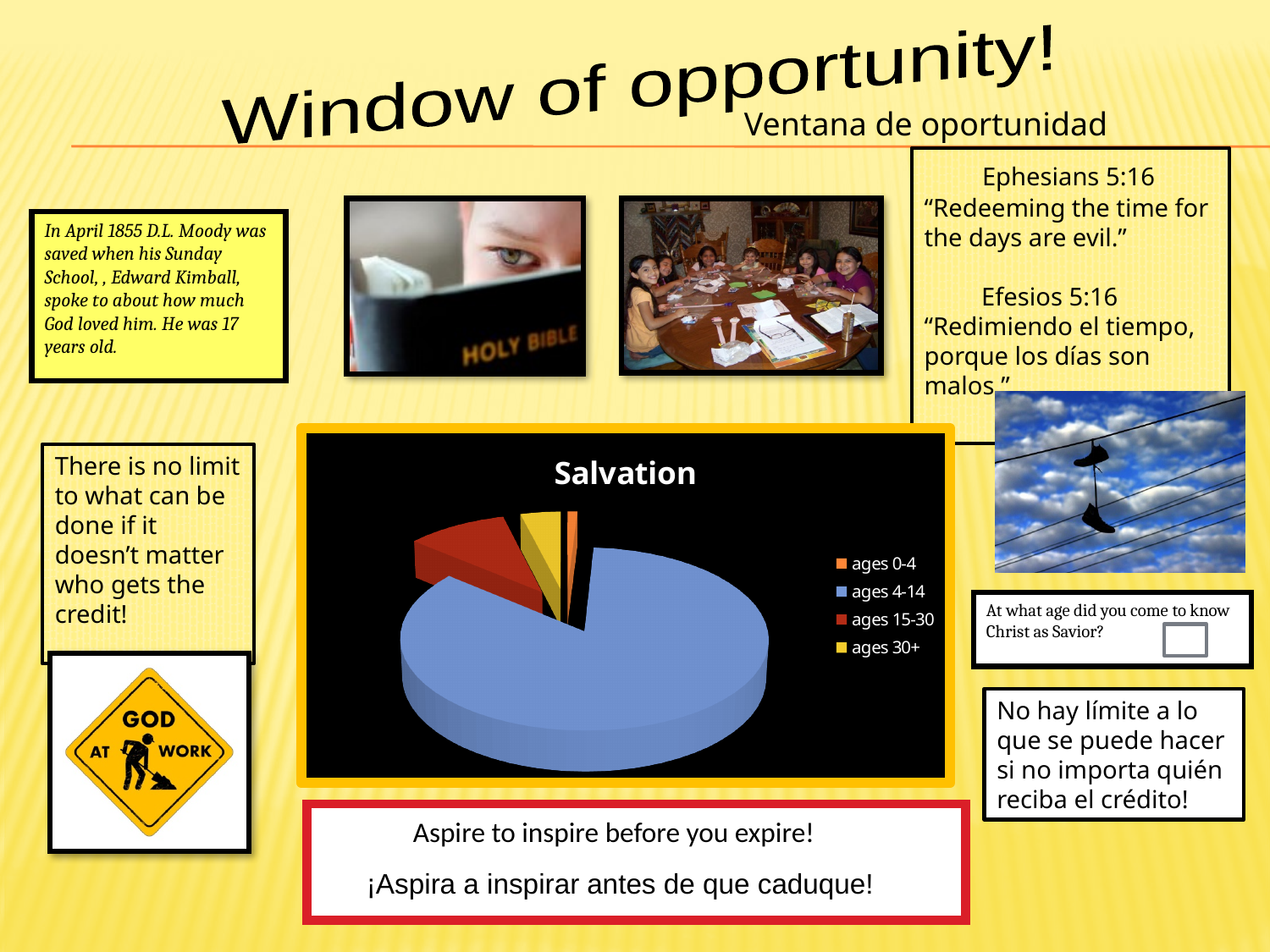
Which slice is larger, ages 15-30 or ages 30+? ages 15-30 How many categories does the pie chart have? 4 What kind of chart is shown on the slide? Pie chart Which slice is larger, ages 30+ or ages 0-4? ages 30+ Which slice is larger, ages 4-14 or ages 15-30? ages 4-14 Which age group has the smallest slice of the pie? ages 0-4 What is the title of the chart? Salvation How many entries does the chart legend list? 4 Which age group has the largest slice of the pie? ages 4-14 What colour represents ages 4-14 in the pie chart? Blue